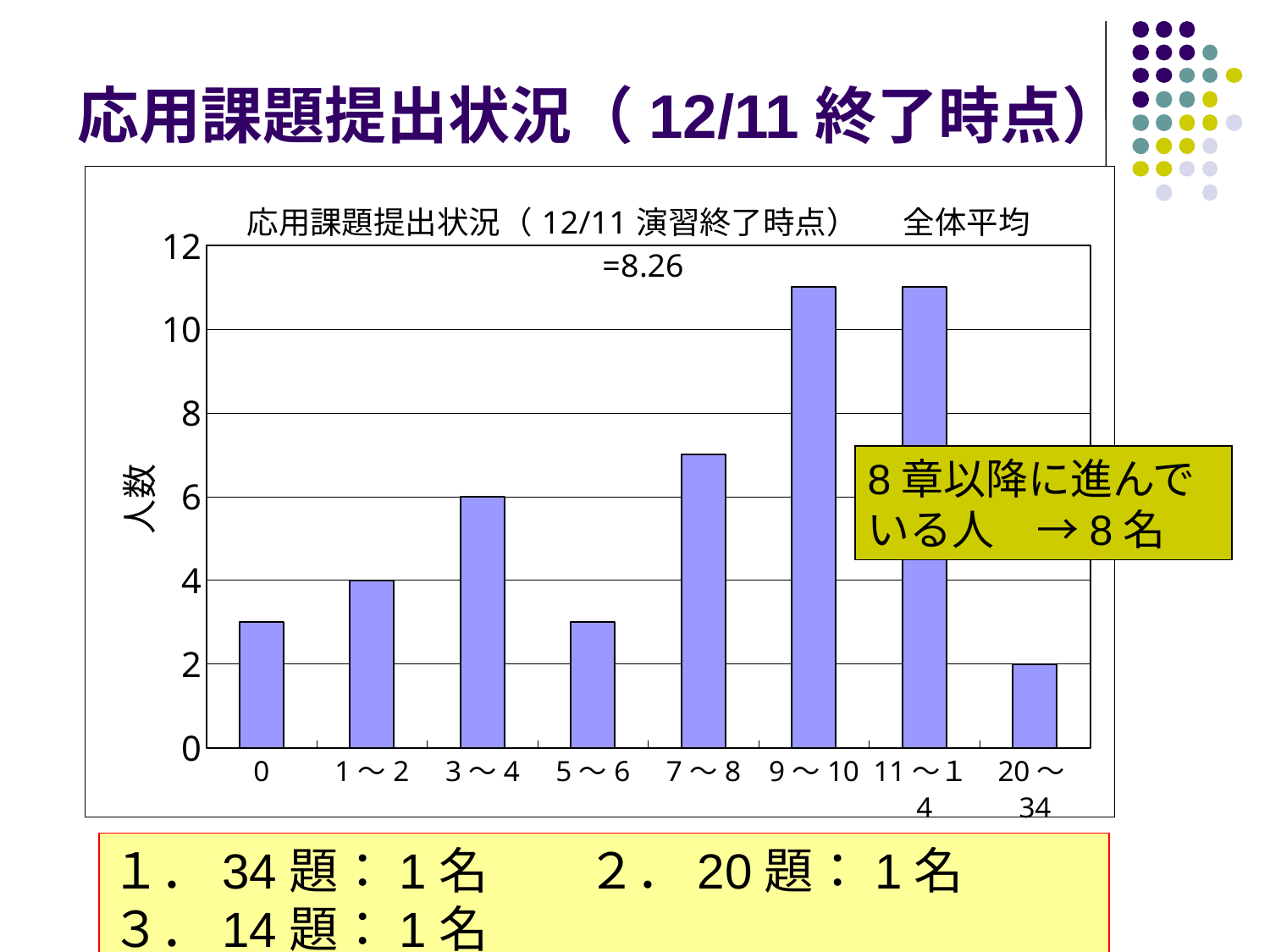
Is the value for the category 9～10 greater or less than 10? greater Which category has the lowest value in the chart? 20～34 Is the value for the category 7～8 greater or less than 6? greater What overall average (全体平均) is stated in the chart title? 8.26 What is the value (人数) for the category 1～2? 4 How many categories are shown on the x axis of the chart? 8 Is the value for the category 0 greater or less than 4? less What is the difference between the values for 3～4 and 20～34? 4 What is the value (人数) for the category 3～4? 6 What is the value (人数) for the category 20～34? 2 Which category has a larger value, 3～4 or 1～2? 3～4 What kind of chart is shown on the slide? bar chart